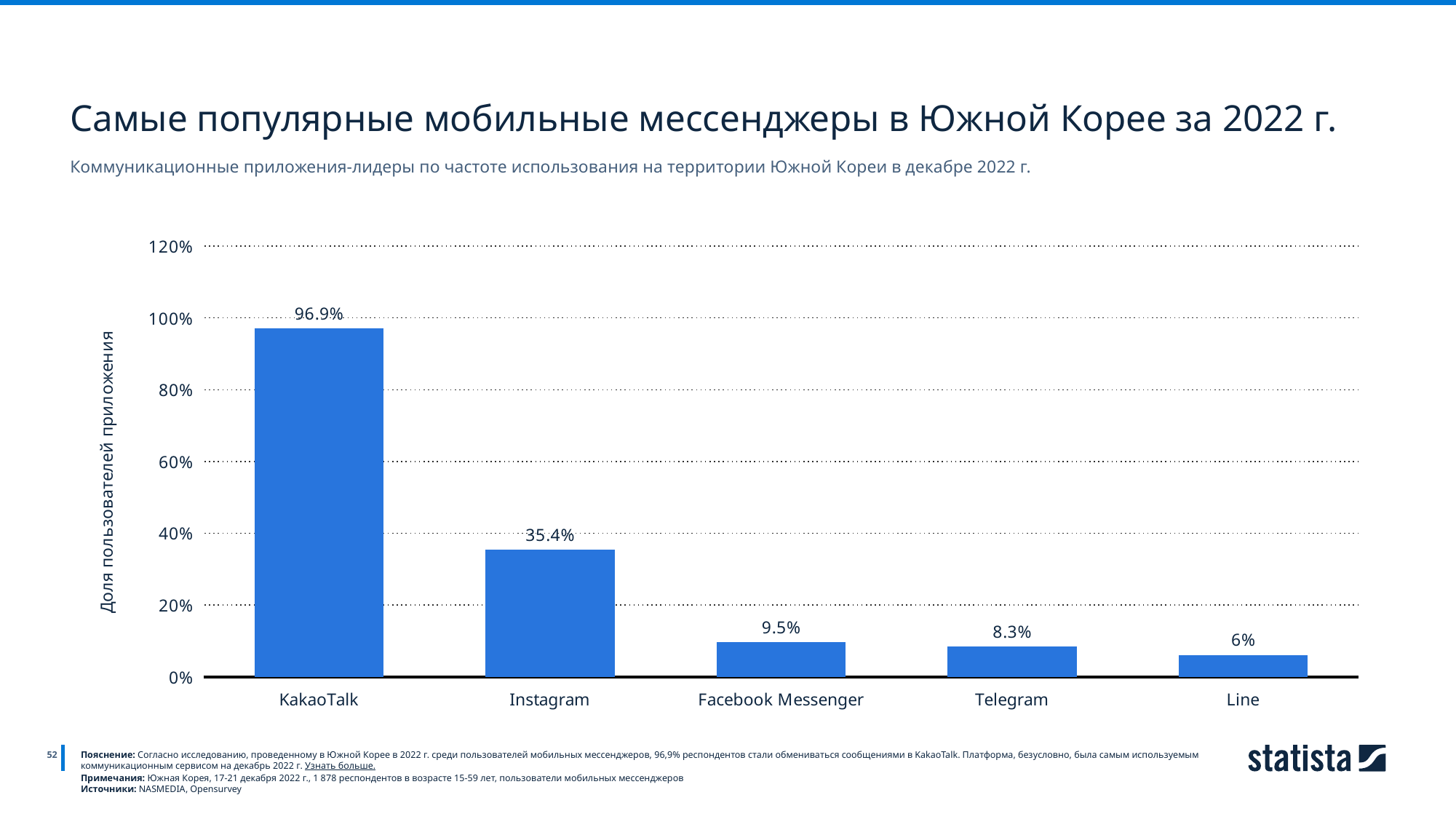
What is the value for Instagram? 35.4% Which messenger has the highest share of app users? KakaoTalk What is the value for Telegram? 8.3% What is the value for Facebook Messenger? 9.5% What is the value for KakaoTalk? 96.9% Which messenger has the lowest share of app users? Line Do the values rise or fall from left to right along the x axis? Fall Which is larger, the value for Facebook Messenger or the value for Telegram? Facebook Messenger What is the value for Line? 6% What kind of chart is shown on the slide? Bar chart What is the difference between the values for KakaoTalk and Instagram? 61.5% How many messengers are shown on the chart? 5